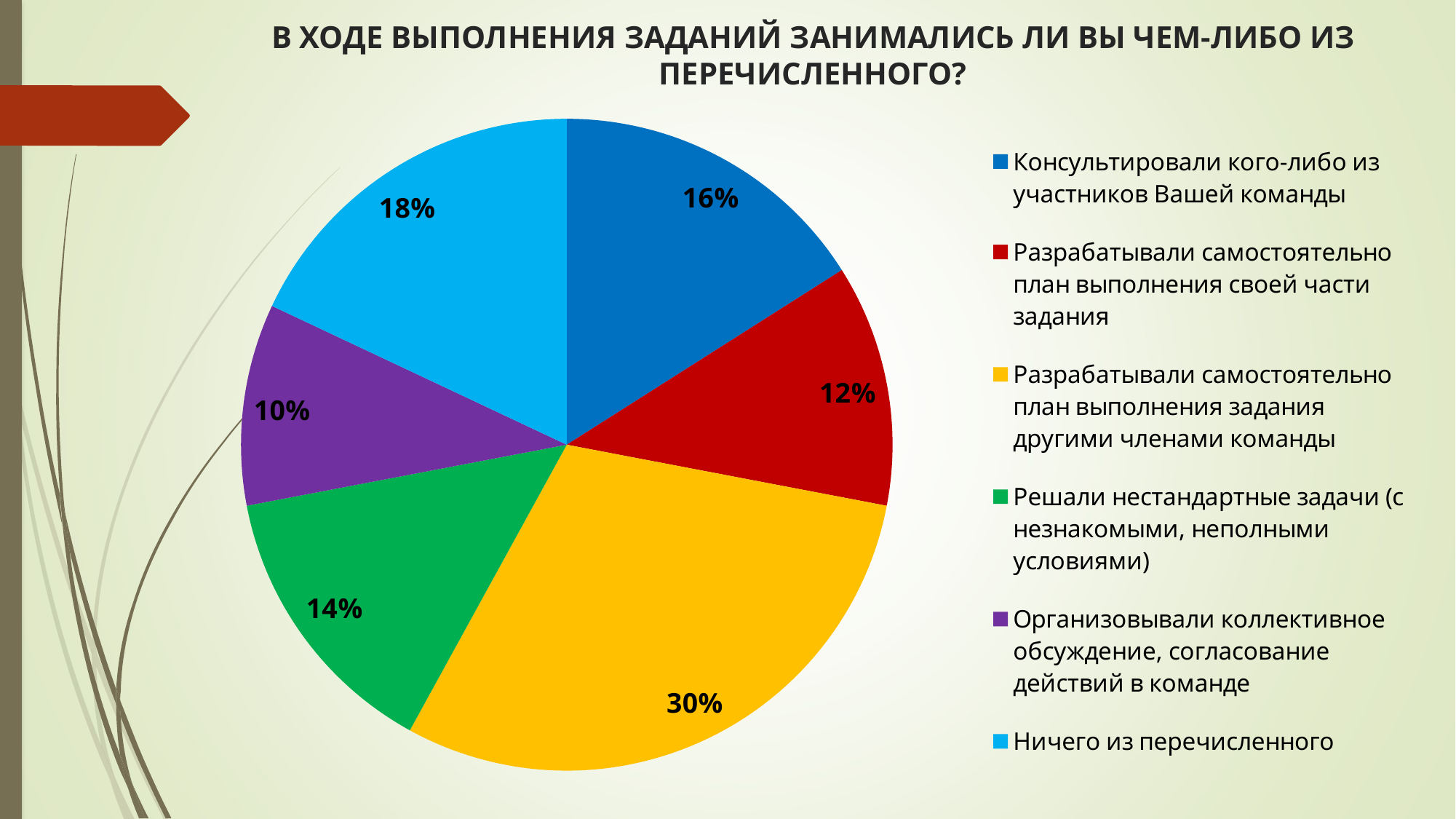
Which is larger: the slice for "Ничего из перечисленного" or the slice for "Разрабатывали самостоятельно план выполнения своей части задания"? Ничего из перечисленного Which category has the smallest slice of the pie? Организовывали коллективное обсуждение, согласование действий в команде What percentage is shown for "Консультировали кого-либо из участников Вашей команды"? 16% What percentage is shown for "Организовывали коллективное обсуждение, согласование действий в команде"? 10% What percentage is shown for "Разрабатывали самостоятельно план выполнения задания другими членами команды"? 30% How many entries does the legend list? 6 What share of the pie is labelled "Ничего из перечисленного"? 18% What is the difference in percentage points between the largest slice (30%) and the "Решали нестандартные задачи" slice (14%)? 16 How many slices does the pie chart have? 6 What colour is the slice for "Решали нестандартные задачи (с незнакомыми, неполными условиями)"? green Which category has the largest slice of the pie? Разрабатывали самостоятельно план выполнения задания другими членами команды What kind of chart is shown on the slide? pie chart